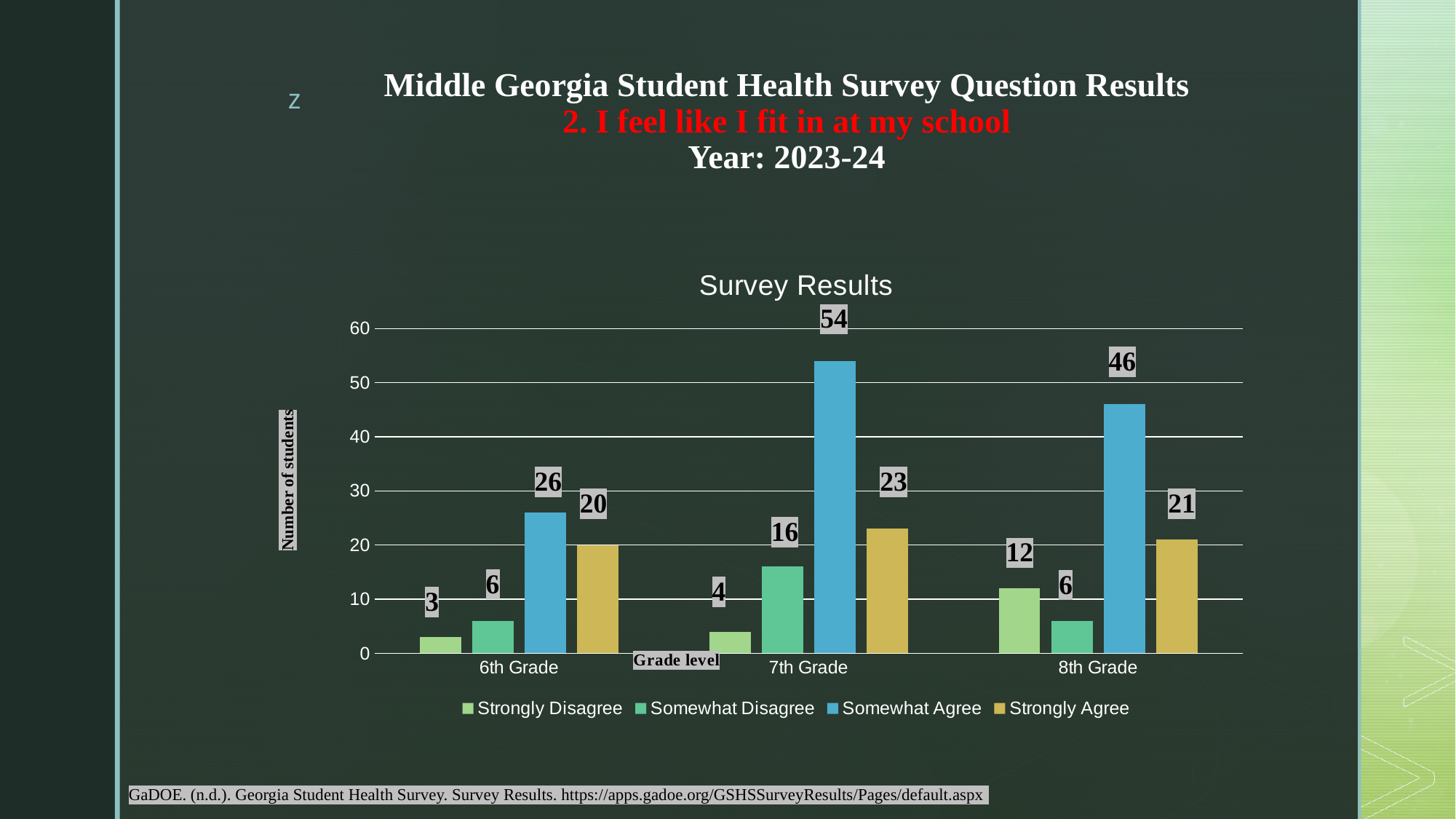
Which grade has the lowest Strongly Disagree value? 6th Grade What kind of chart is shown? bar chart Which is larger: Somewhat Disagree in 7th Grade or Somewhat Disagree in 8th Grade? Somewhat Disagree in 7th Grade Is the value for Somewhat Agree in 8th Grade greater or less than 40? greater What is the value for Somewhat Agree in 7th Grade? 54 How many grade levels are shown on the x axis? 3 Which grade has the highest Somewhat Agree value? 7th Grade What is the difference between the Somewhat Agree values for 7th Grade and 8th Grade? 8 What is the title of the chart? Survey Results How many series does the legend list? 4 What is the value for Strongly Disagree in 8th Grade? 12 What is the value for Strongly Agree in 6th Grade? 20